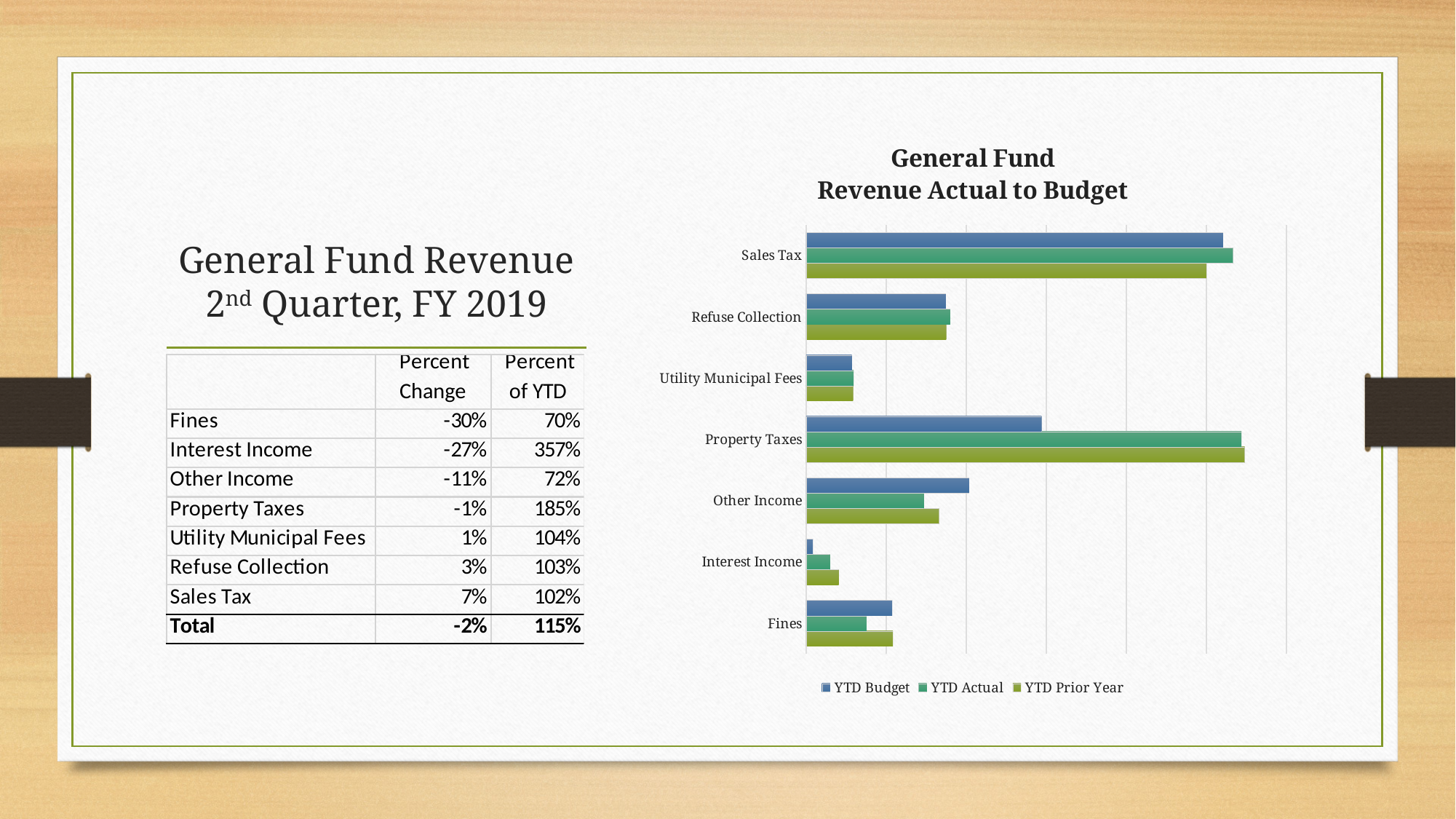
How many series does the legend of the General Fund Revenue Actual to Budget chart list? 3 Which category has the shortest YTD Budget bar on the General Fund Revenue Actual to Budget chart? Interest Income Which category has the longest YTD Budget bar on the General Fund Revenue Actual to Budget chart? Sales Tax How many revenue categories are shown on the General Fund Revenue Actual to Budget chart? 7 What is the title of the chart on the slide? General Fund Revenue Actual to Budget For Fines, which is larger on the General Fund Revenue Actual to Budget chart: YTD Budget or YTD Actual? YTD Budget What kind of chart is the General Fund Revenue Actual to Budget chart? bar chart Which category has the longest YTD Actual bar on the General Fund Revenue Actual to Budget chart? Property Taxes Which category has the shortest YTD Actual bar on the General Fund Revenue Actual to Budget chart? Interest Income For Property Taxes, which is larger on the General Fund Revenue Actual to Budget chart: YTD Budget or YTD Actual? YTD Actual For Other Income, which is larger on the General Fund Revenue Actual to Budget chart: YTD Budget or YTD Actual? YTD Budget Which series is shown in blue on the General Fund Revenue Actual to Budget chart? YTD Budget